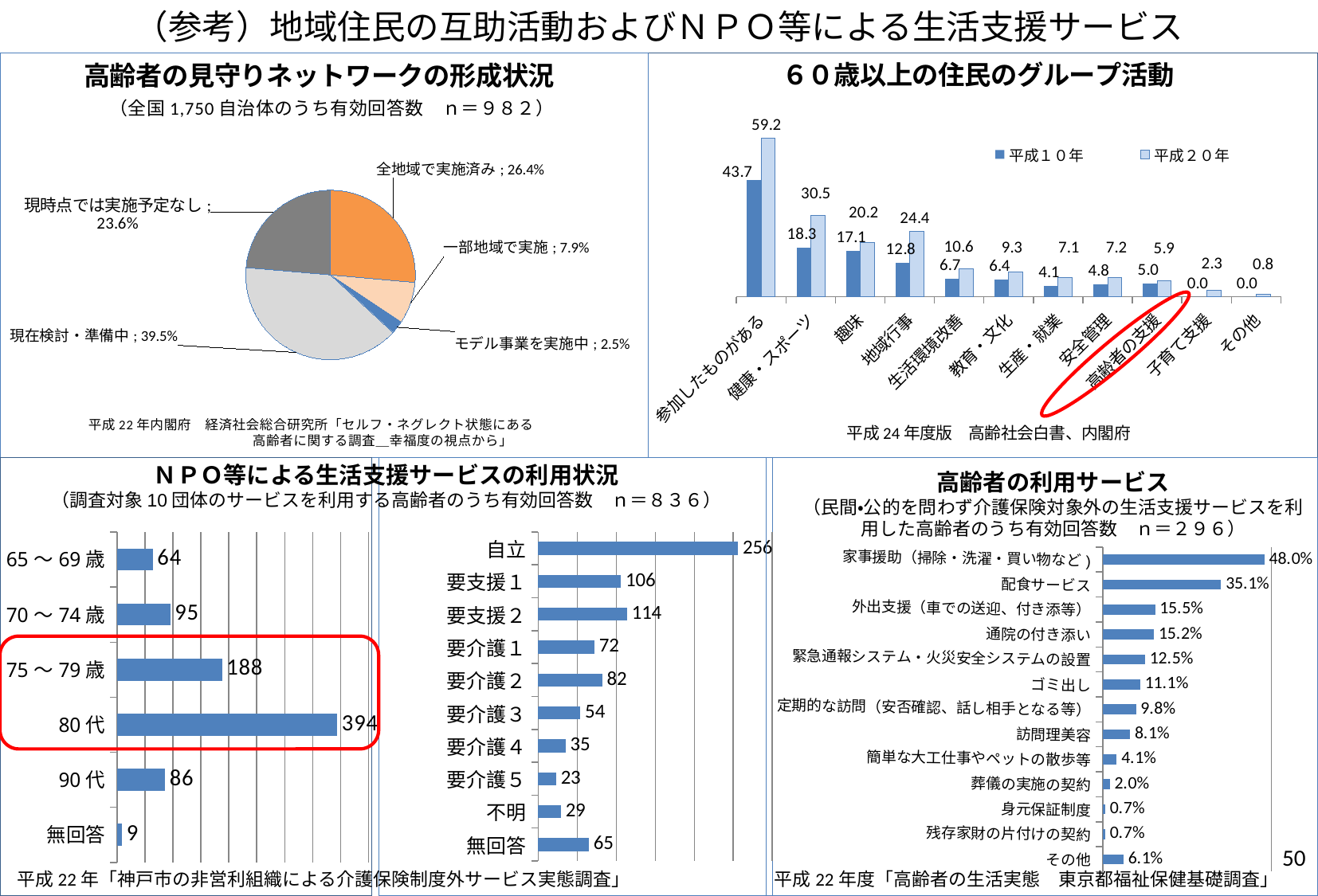
In the age-group bar chart of ＮＰＯ等による生活支援サービスの利用状況, what is the value for 80代? 394 In the chart ６０歳以上の住民のグループ活動, what is the difference between the 平成２０年 and 平成１０年 values for 健康・スポーツ? 12.2 In the chart ６０歳以上の住民のグループ活動, what is the 平成２０年 value for 地域行事? 24.4 In the pie chart 高齢者の見守りネットワークの形成状況, which category has the smallest share? モデル事業を実施中 In the pie chart 高齢者の見守りネットワークの形成状況, what share is 現在検討・準備中? 39.5% In the pie chart 高齢者の見守りネットワークの形成状況, how many slices are there? 5 In the care-level bar chart of ＮＰＯ等による生活支援サービスの利用状況, which category is larger, 要支援１ or 要支援２? 要支援２ In the chart ６０歳以上の住民のグループ活動, which category has the highest 平成１０年 value? 参加したものがある In the age-group bar chart of ＮＰＯ等による生活支援サービスの利用状況, what is the difference between 80代 and 75～79歳? 206 In the chart ６０歳以上の住民のグループ活動, how many series does the legend list? 2 In the chart 高齢者の利用サービス, what is the value for 配食サービス? 35.1% What kind of chart is 高齢者の利用サービス? bar chart